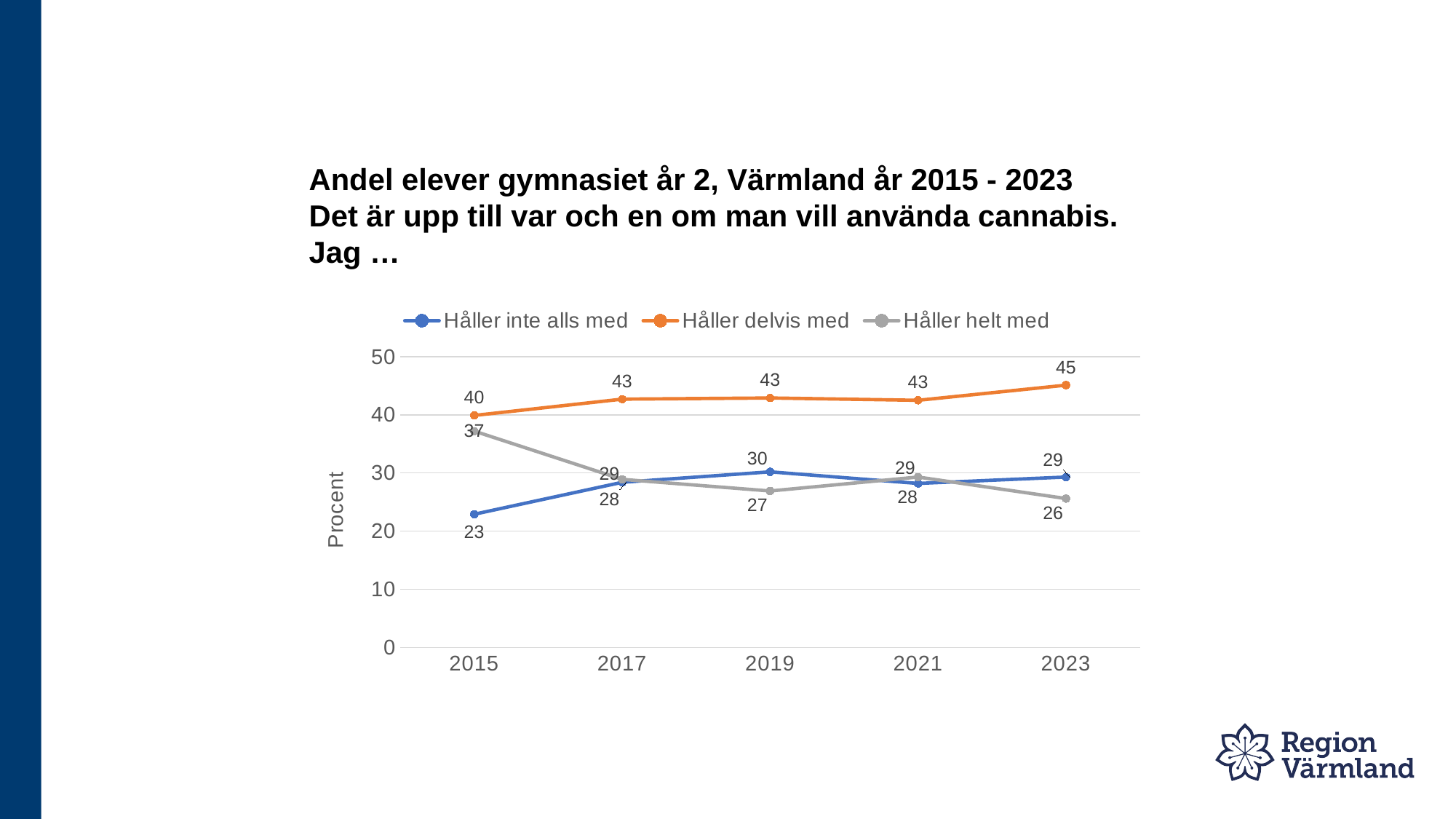
In which year is the value for Håller helt med lowest? 2023 How many series does the legend list? 3 What is the value for Håller helt med in 2015? 37 Which series has the larger value in 2023, Håller inte alls med or Håller helt med? Håller inte alls med Does the value for Håller helt med rise or fall from 2015 to 2023? Fall In which year is the value for Håller inte alls med highest? 2019 What is the value for Håller helt med in 2023? 26 What is the value for Håller inte alls med in 2015? 23 What kind of chart is shown on the slide? Line chart What is the value for Håller delvis med in 2023? 45 What is the difference between Håller delvis med and Håller inte alls med in 2015? 17 How many years are shown on the x axis? 5